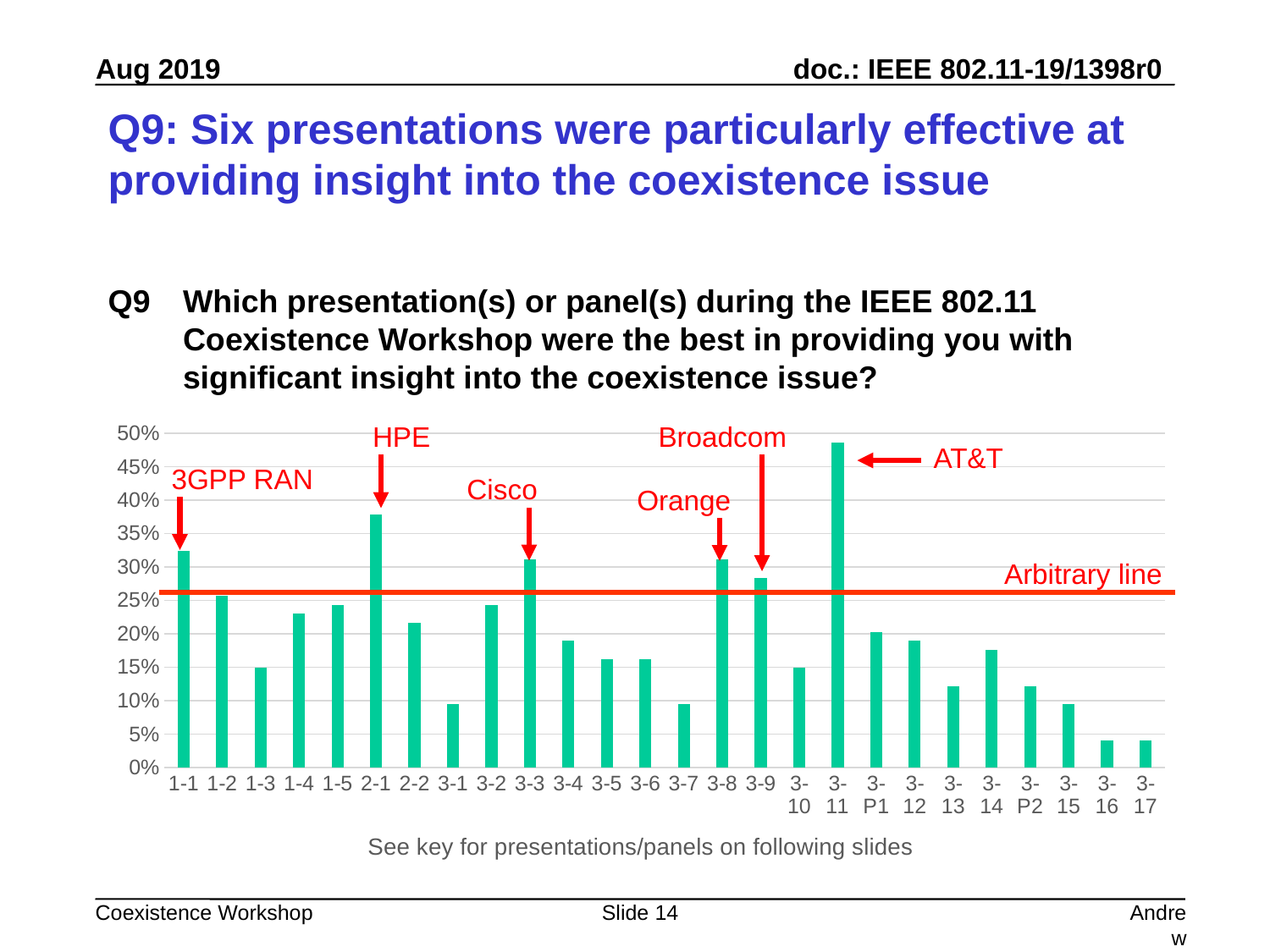
What kind of chart is shown on the slide? bar chart How many presentations/panels (categories) are plotted on the x axis? 26 Which presentation/panel has the highest value? 3-11 Which presentation/panel is labelled with the annotation "AT&T"? 3-11 What is the label of the horizontal red line drawn across the chart? Arbitrary line Which has the larger value, 2-1 or 3-3? 2-1 Is the value for 2-1 greater or less than 35%? greater Is the value for 3-11 greater or less than 45%? greater Is the value for 1-1 greater or less than 30%? greater